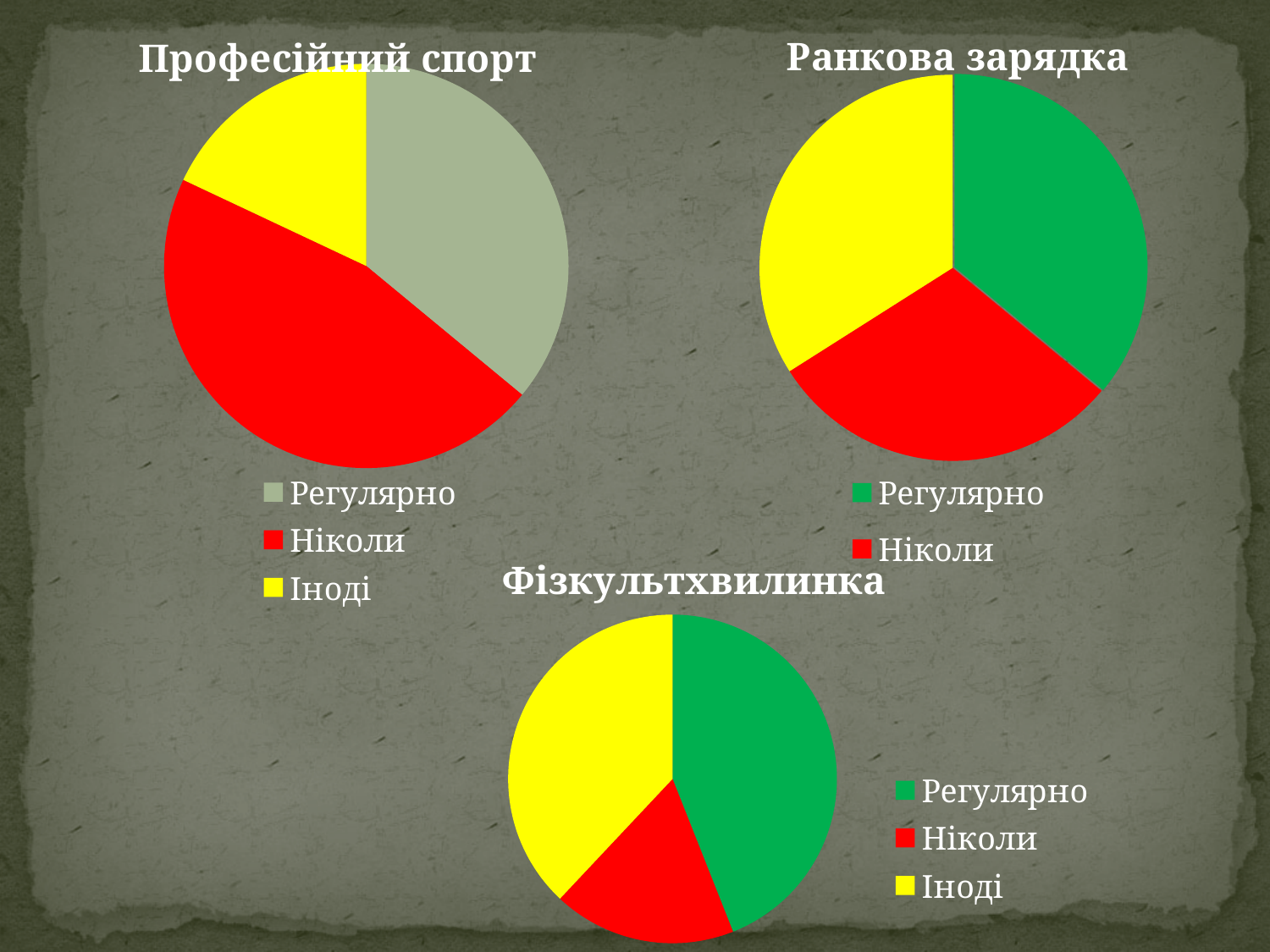
In the "Фізкультхвилинка" chart, which category has the smallest slice? Ніколи In the "Професійний спорт" chart, which category has the smallest slice? Іноді In the "Професійний спорт" chart, which slice is larger: Регулярно or Іноді? Регулярно In the "Ранкова зарядка" chart, which category has the smallest slice? Ніколи How many slices does the "Професійний спорт" pie chart have? 3 In the "Фізкультхвилинка" chart, which category has the largest slice? Регулярно In the "Професійний спорт" chart, which category has the largest slice? Ніколи What kind of chart is the "Професійний спорт" chart? pie chart In the "Ранкова зарядка" chart, which slice is larger: Іноді or Ніколи? Іноді In the "Фізкультхвилинка" chart, what colour is the Іноді slice? yellow How many entries does the legend of the "Професійний спорт" chart list? 3 How many entries does the legend of the "Фізкультхвилинка" chart list? 3